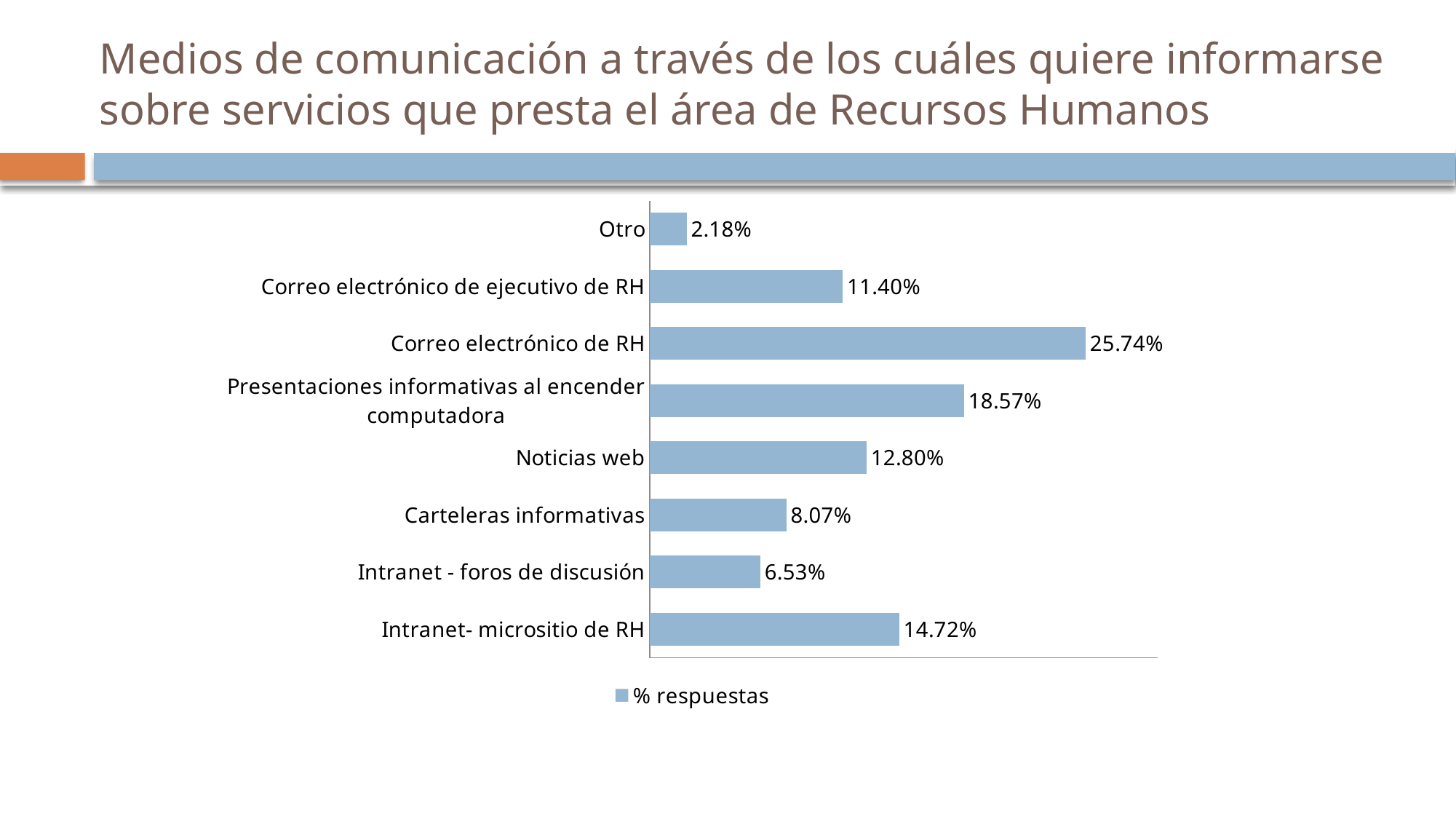
Which category has the lowest value? Otro What is the difference between Correo electrónico de RH and Correo electrónico de ejecutivo de RH? 14.34% What kind of chart is shown on the slide? Bar chart What is the value for Correo electrónico de RH? 25.74% Which is larger, Noticias web or Intranet- micrositio de RH? Intranet- micrositio de RH What is the value for Intranet- micrositio de RH? 14.72% Which category has the highest value? Correo electrónico de RH What is the difference between Carteleras informativas and Intranet - foros de discusión? 1.54% What series name does the legend show? % respuestas What is the value for Presentaciones informativas al encender computadora? 18.57% What is the value for Noticias web? 12.80% How many categories are shown in the chart? 8